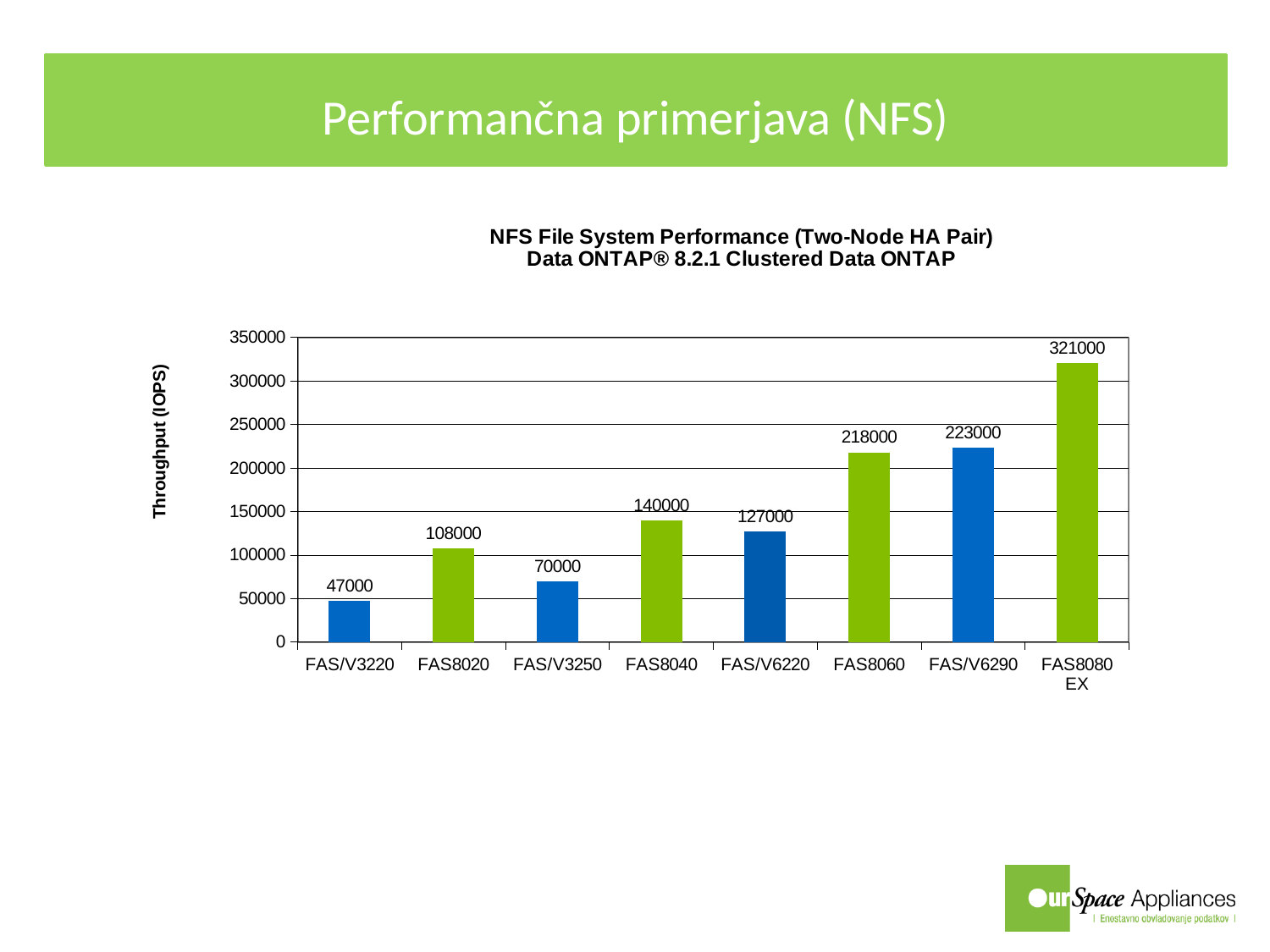
What is the label of the y axis? Throughput (IOPS) Is the throughput for FAS8060 greater or less than 200000? greater What is the throughput value for FAS/V6290? 223000 How many systems are shown on the x axis? 8 What is the throughput value for FAS/V3220? 47000 Which system has the lowest throughput? FAS/V3220 What kind of chart is shown on the slide? bar chart What is the difference in throughput between FAS8080 EX and FAS8060? 103000 What is the throughput value for FAS8040? 140000 Which has a higher throughput, FAS8040 or FAS/V6220? FAS8040 Which system has the highest throughput? FAS8080 EX What is the difference in throughput between FAS8020 and FAS/V3250? 38000